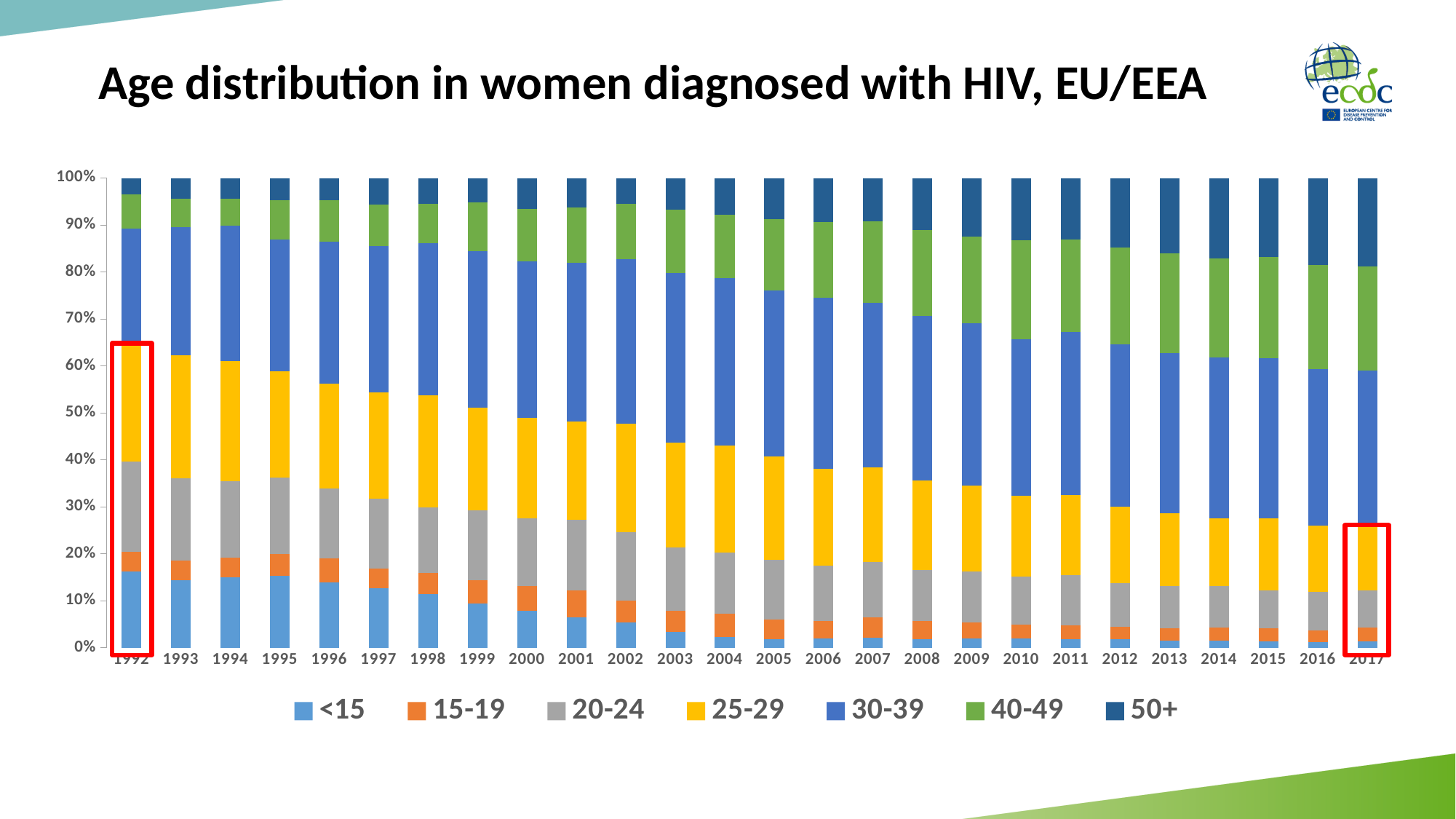
What is the title of the chart? Age distribution in women diagnosed with HIV, EU/EEA Which year has the larger share for the 30-39 age group, 1992 or 2017? 2017 Does the share of the <15 age group rise or fall from 1992 to 2017? fall How many years are shown along the x axis? 26 Which two years are highlighted with red boxes on the chart? 1992 and 2017 Which year has the larger share for the 20-24 age group, 1992 or 2017? 1992 Is the share of the 40-49 age group in 1992 greater or less than 10%? less What kind of chart is shown on the slide? bar chart Is the share of the <15 age group in 2017 greater or less than 10%? less Is the share of the <15 age group in 1992 greater or less than 10%? greater How many age groups does the legend list? 7 Does the share of the 50+ age group rise or fall from 1992 to 2017? rise